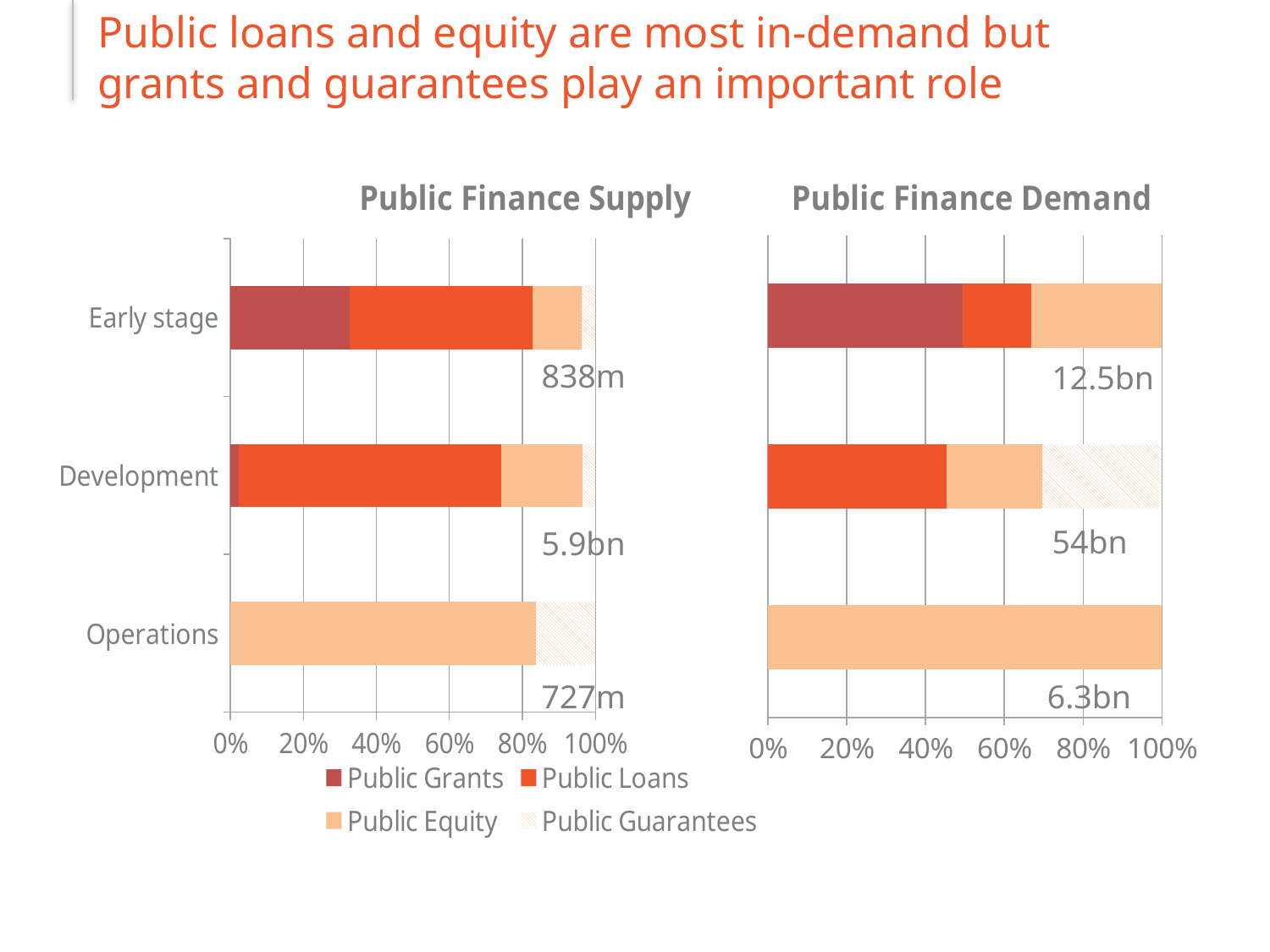
How many series does the legend list for the charts? 4 In the Public Finance Demand chart, what share of the Operations bar is Public Equity? 100% In the Public Finance Supply chart, which category has the larger Public Grants share, Early stage or Development? Early stage What type of chart is the Public Finance Supply chart? bar chart How many categories are shown on the Public Finance Demand chart? 3 In the Public Finance Supply chart, is the Public Equity share for Operations greater or less than 60%? greater In the Public Finance Demand chart, what total is printed next to the Early stage bar? 12.5bn In the Public Finance Demand chart, is the Public Grants share for Early stage greater or less than 40%? greater Which legend entry is shown with a hatched pattern rather than a solid colour? Public Guarantees In the Public Finance Supply chart, what total is printed next to the Development bar? 5.9bn In the Public Finance Supply chart, is the Public Grants share for Early stage greater or less than 20%? greater In the Public Finance Demand chart, which category has the largest Public Loans share? Development